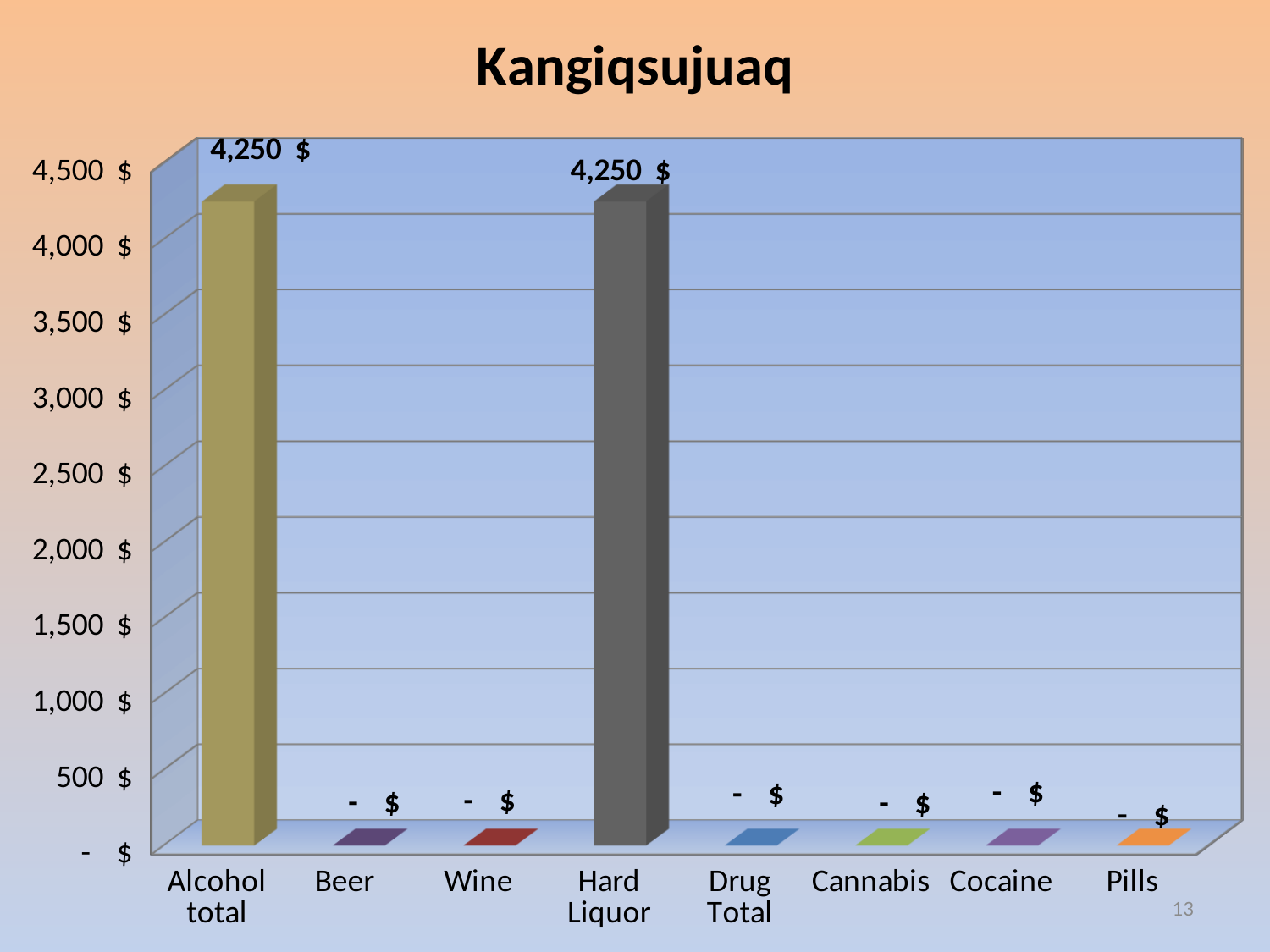
Which is larger, the value for Alcohol total or the value for Wine? Alcohol total Which is larger, the value for Hard Liquor or the value for Cannabis? Hard Liquor What is the value for Hard Liquor? 4,250 $ What is the value for Alcohol total? 4,250 $ What is the difference between the value for Alcohol total and the value for Hard Liquor? - $ What value is shown for Drug Total? - $ What is the title of the chart? Kangiqsujuaq What kind of chart is shown on the slide? bar chart What value is shown for Beer? - $ Is the value for Hard Liquor greater or less than 4,500 $? less How many categories are shown on the x axis? 8 Is the value for Alcohol total greater or less than 4,000 $? greater